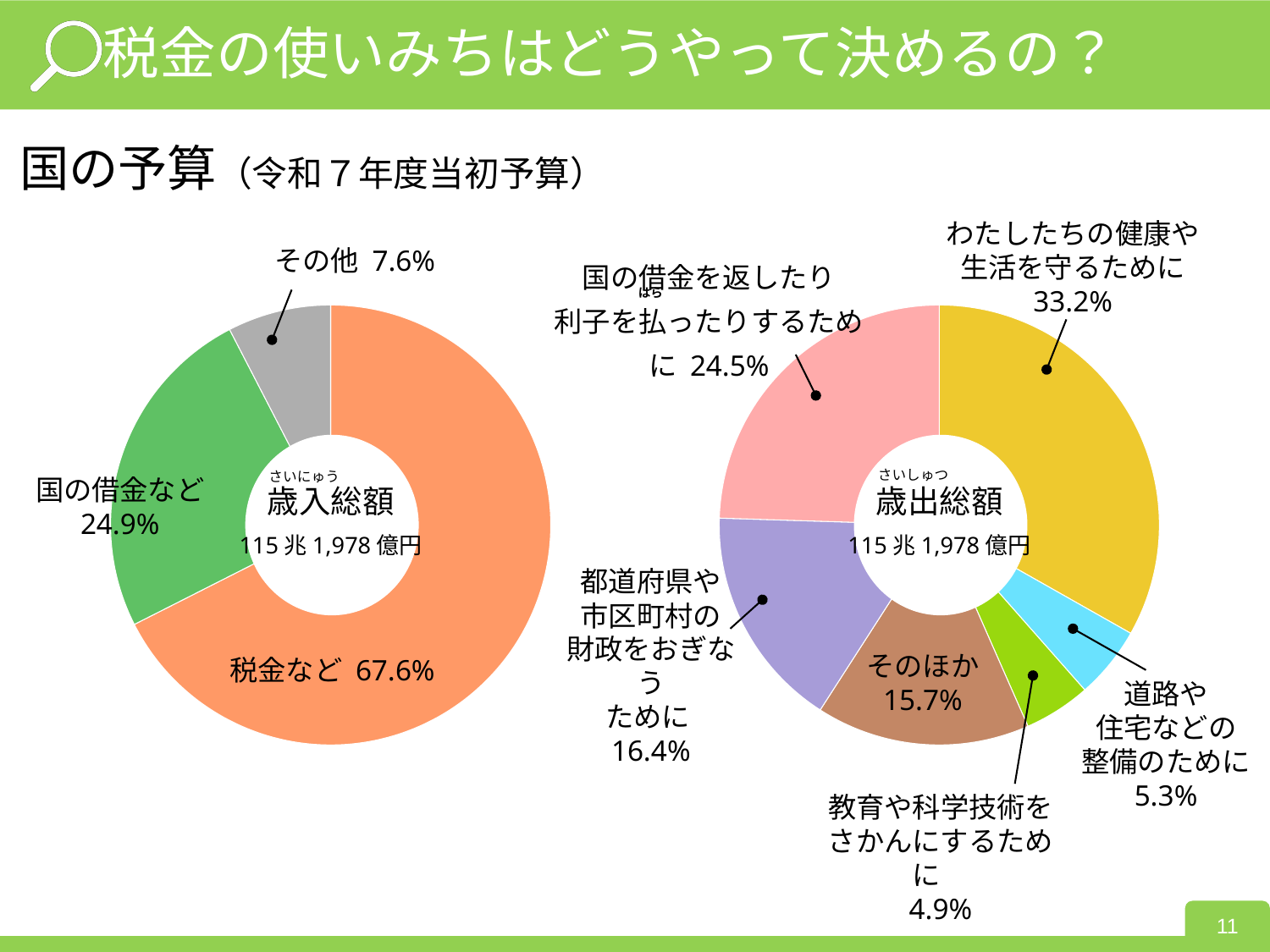
歳出総額のグラフで、「国の借金を返したり利子を払ったりするために」と「道路や住宅などの整備のために」の割合の差は何ポイントですか？ 19.2ポイント 歳出総額のグラフで、「都道府県や市区町村の財政をおぎなうために」と「そのほか」では、どちらの割合が大きいですか？ 都道府県や市区町村の財政をおぎなうために 歳出総額のグラフで、最も割合が大きい項目はどれですか？ わたしたちの健康や生活を守るために 歳入総額のグラフで、「税金など」の割合は何%ですか？ 67.6% 歳入総額のグラフで、「税金など」と「国の借金など」の割合の差は何ポイントですか？ 42.7ポイント 歳出総額のグラフで、「わたしたちの健康や生活を守るために」の割合は何%ですか？ 33.2% このスライドのグラフはどのような種類のグラフですか？ 円グラフ（ドーナツグラフ） 歳入総額のグラフには、いくつの項目がありますか？ 3 歳入総額のグラフで、「国の借金など」の割合は何%ですか？ 24.9% 歳出総額のグラフで、「教育や科学技術をさかんにするために」の割合は何%ですか？ 4.9% 歳入総額のグラフで、最も割合が小さい項目はどれですか？ その他 歳出総額のグラフには、いくつの項目がありますか？ 6